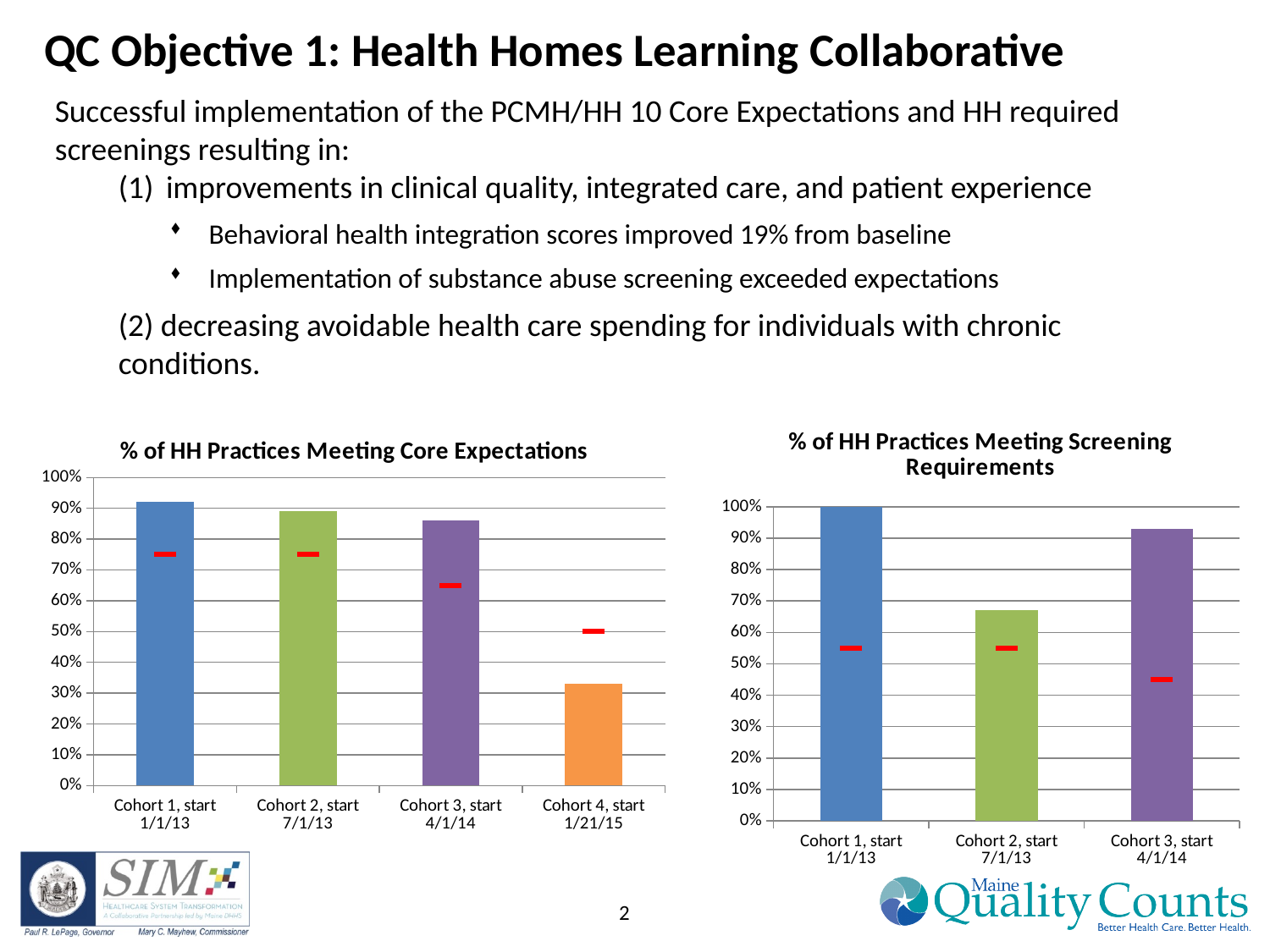
In the '% of HH Practices Meeting Core Expectations' chart, is the value for Cohort 1, start 1/1/13 greater or less than 90%? greater In the '% of HH Practices Meeting Screening Requirements' chart, which cohort has the lowest value? Cohort 2, start 7/1/13 How many cohorts are shown in the '% of HH Practices Meeting Core Expectations' chart? 4 How many cohorts are shown in the '% of HH Practices Meeting Screening Requirements' chart? 3 In the '% of HH Practices Meeting Core Expectations' chart, which cohort has the lowest value? Cohort 4, start 1/21/15 In the '% of HH Practices Meeting Core Expectations' chart, is the value for Cohort 4, start 1/21/15 greater or less than 40%? less In the '% of HH Practices Meeting Core Expectations' chart, do the values rise or fall from Cohort 1 to Cohort 4 along the x axis? fall What kind of chart is '% of HH Practices Meeting Core Expectations'? bar chart In the '% of HH Practices Meeting Screening Requirements' chart, is the value for Cohort 2, start 7/1/13 greater or less than 70%? less In the '% of HH Practices Meeting Screening Requirements' chart, what is the value for Cohort 1, start 1/1/13? 100% In the '% of HH Practices Meeting Screening Requirements' chart, which is larger: Cohort 3, start 4/1/14 or Cohort 2, start 7/1/13? Cohort 3, start 4/1/14 In the '% of HH Practices Meeting Core Expectations' chart, which is larger: Cohort 1, start 1/1/13 or Cohort 4, start 1/21/15? Cohort 1, start 1/1/13